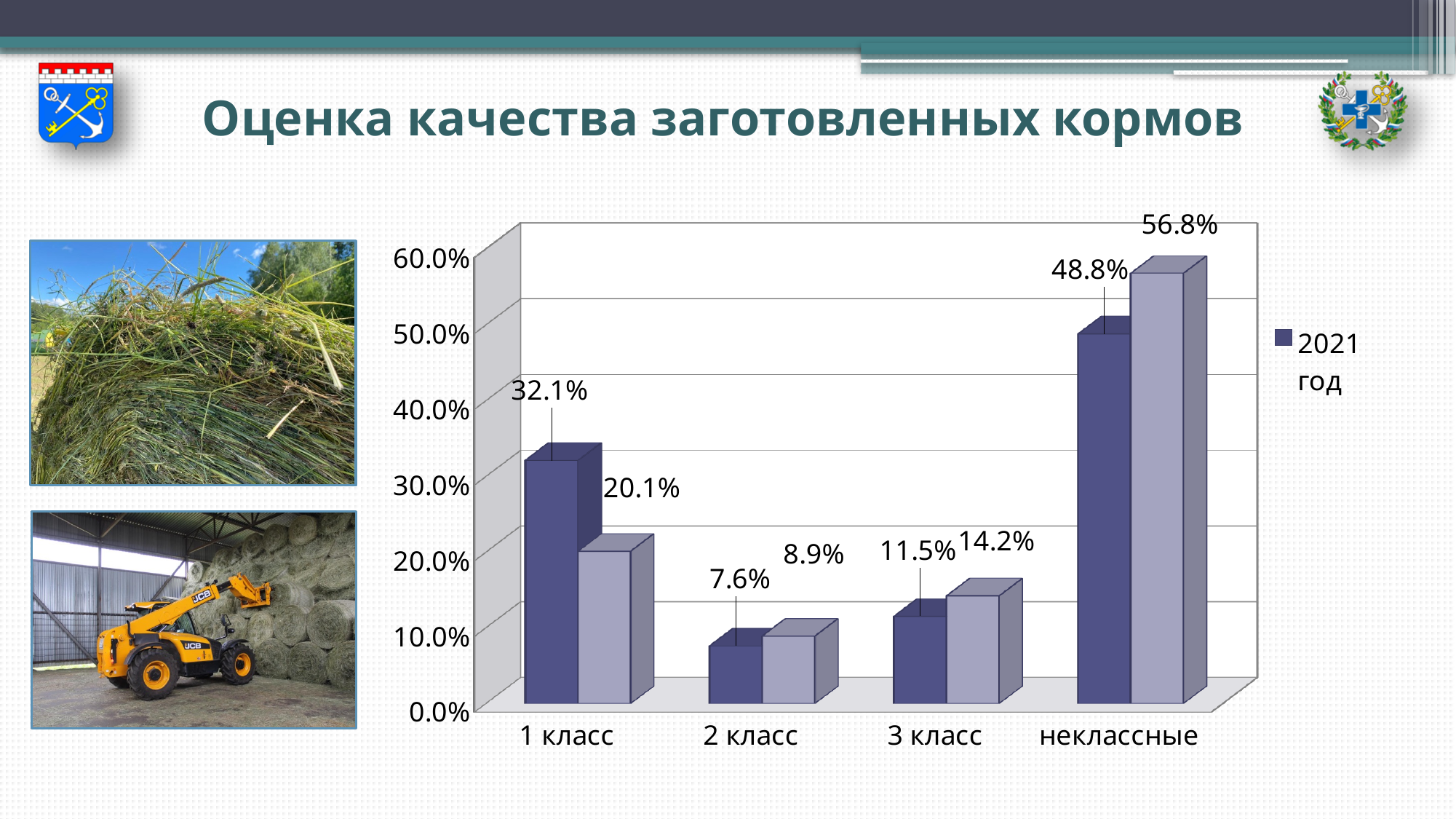
What is the value for 1 класс in the 2021 год series? 32.1% What is the title of the slide containing the chart? Оценка качества заготовленных кормов How many categories are shown on the x axis of the chart? 4 In the 2021 год series, what is the difference between the values for 1 класс and 3 класс? 20.6% Which category has the highest value in the 2021 год series? неклассные What is the value for 3 класс in the 2021 год series? 11.5% Which category has the lowest value in the 2021 год series? 2 класс In the 2021 год series, which is larger: the value for 1 класс or the value for 3 класс? 1 класс In the 2021 год series, what is the difference between the values for неклассные and 1 класс? 16.7% What is the value for 2 класс in the 2021 год series? 7.6% What is the value for неклассные in the 2021 год series? 48.8% What kind of chart is shown on the slide? bar chart